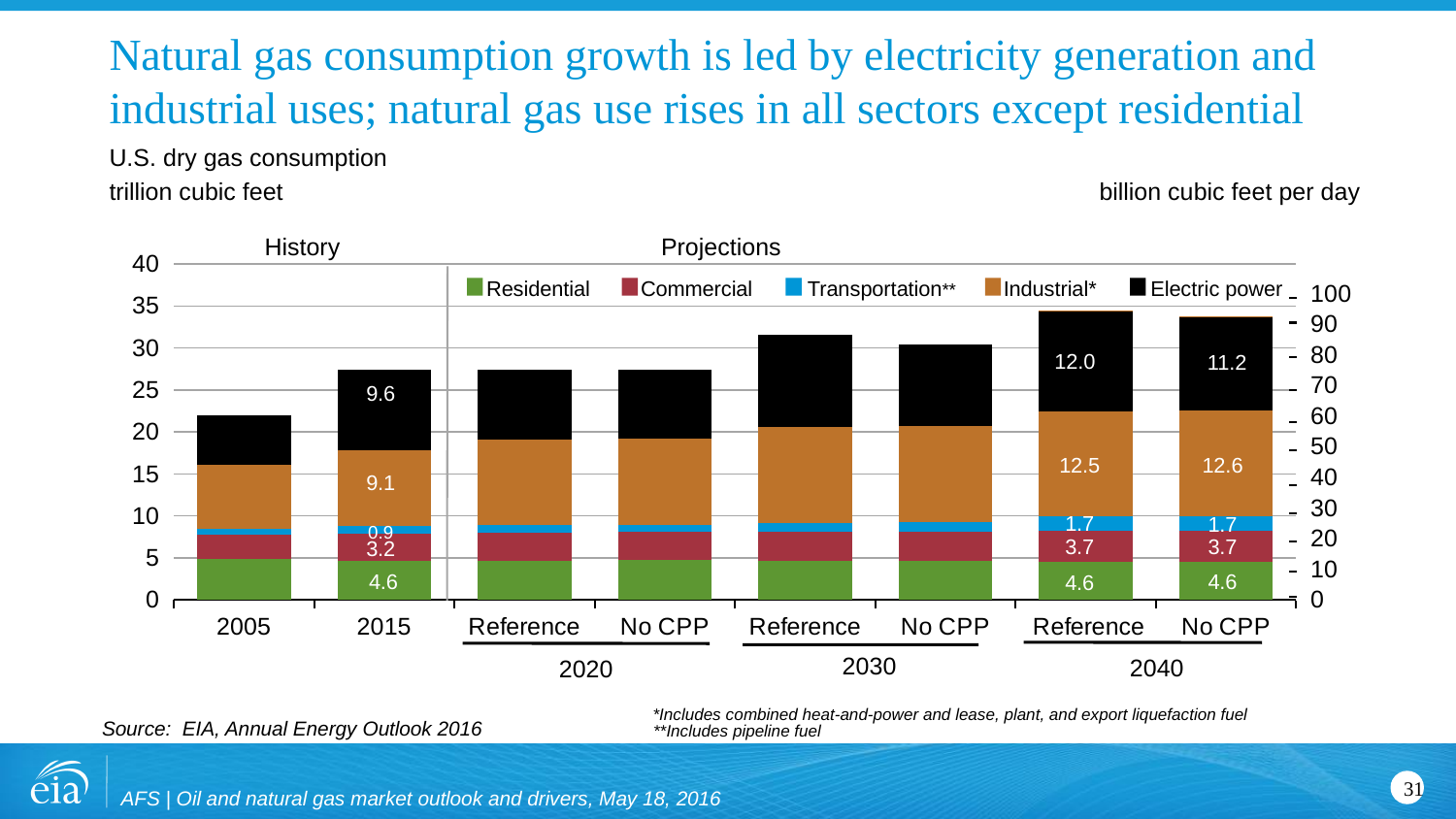
Which has the larger Industrial* value in 2040, Reference or No CPP? No CPP What kind of chart is shown on the slide? Stacked bar chart What is the difference between the Electric power values in the 2040 Reference and 2040 No CPP bars? 0.8 What is the Transportation** value in the 2015 bar? 0.9 What is the Electric power value in the 2040 No CPP bar? 11.2 What is the Industrial* value in the 2040 Reference bar? 12.5 What colour represents Electric power in the legend? Black Is the total of the 2005 bar greater or less than 20 trillion cubic feet? greater How many bars are plotted in the chart? 8 What is the value for Electric power in the 2015 bar? 9.6 What is the total of the 2015 stacked bar? 27.5 How many series does the legend list? 5